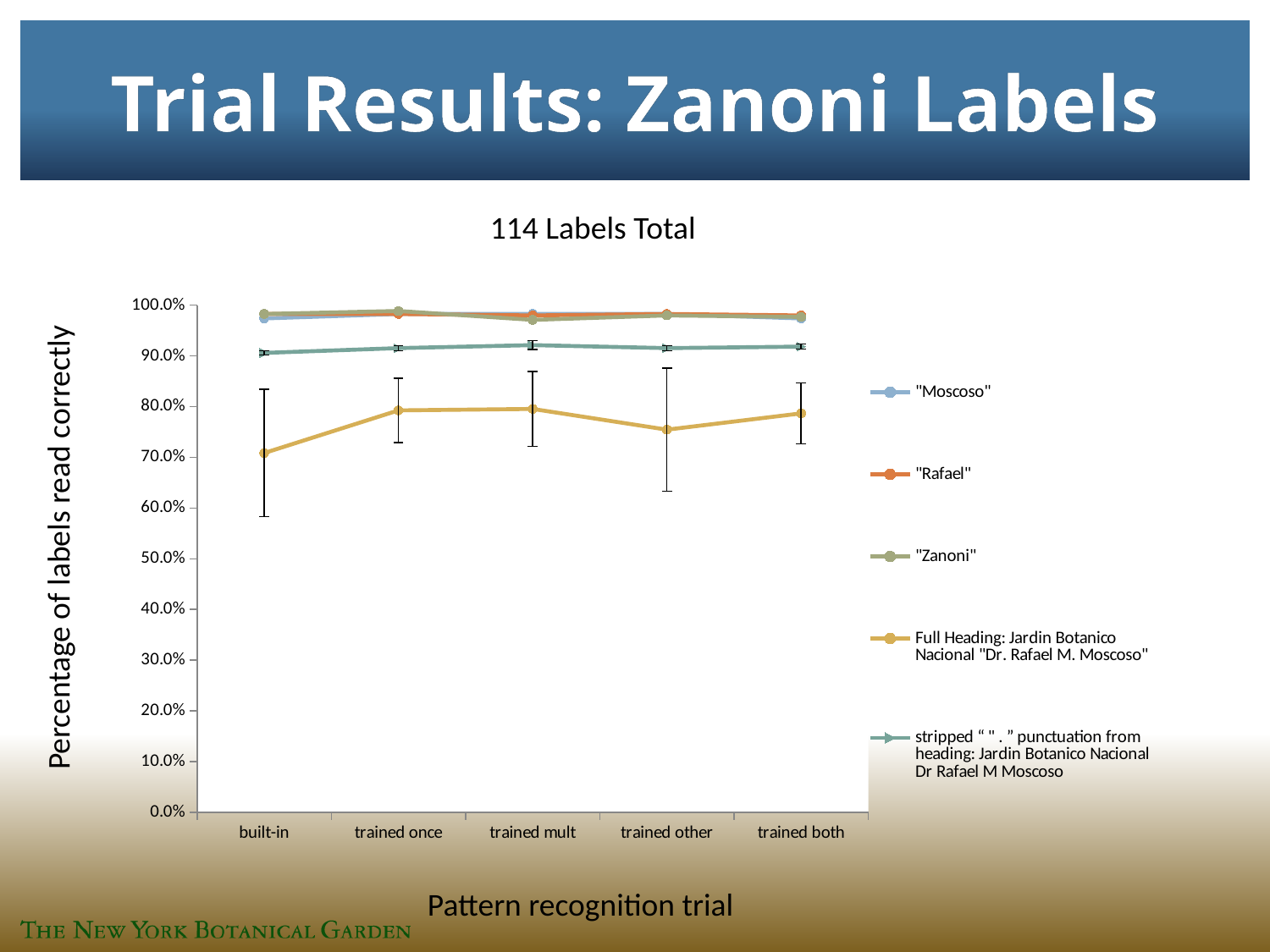
How many series does the legend list? 5 For the Full Heading series, which is larger: the value at built-in or at trained once? trained once Is the value for the stripped punctuation series at trained once greater or less than 80.0%? greater What kind of chart is shown on the slide? line chart Is the value for the Full Heading series at built-in greater or less than 80.0%? less How many pattern recognition trials are shown on the x axis? 5 What is the title of the chart? 114 Labels Total Is the value for the Full Heading series at built-in greater or less than 60.0%? greater What is the label of the vertical axis? Percentage of labels read correctly Does the Full Heading series rise or fall from built-in to trained once? rise For the Full Heading series, which trial has the lowest value? built-in Which series has the lowest values across all trials? Full Heading: Jardin Botanico Nacional "Dr. Rafael M. Moscoso"